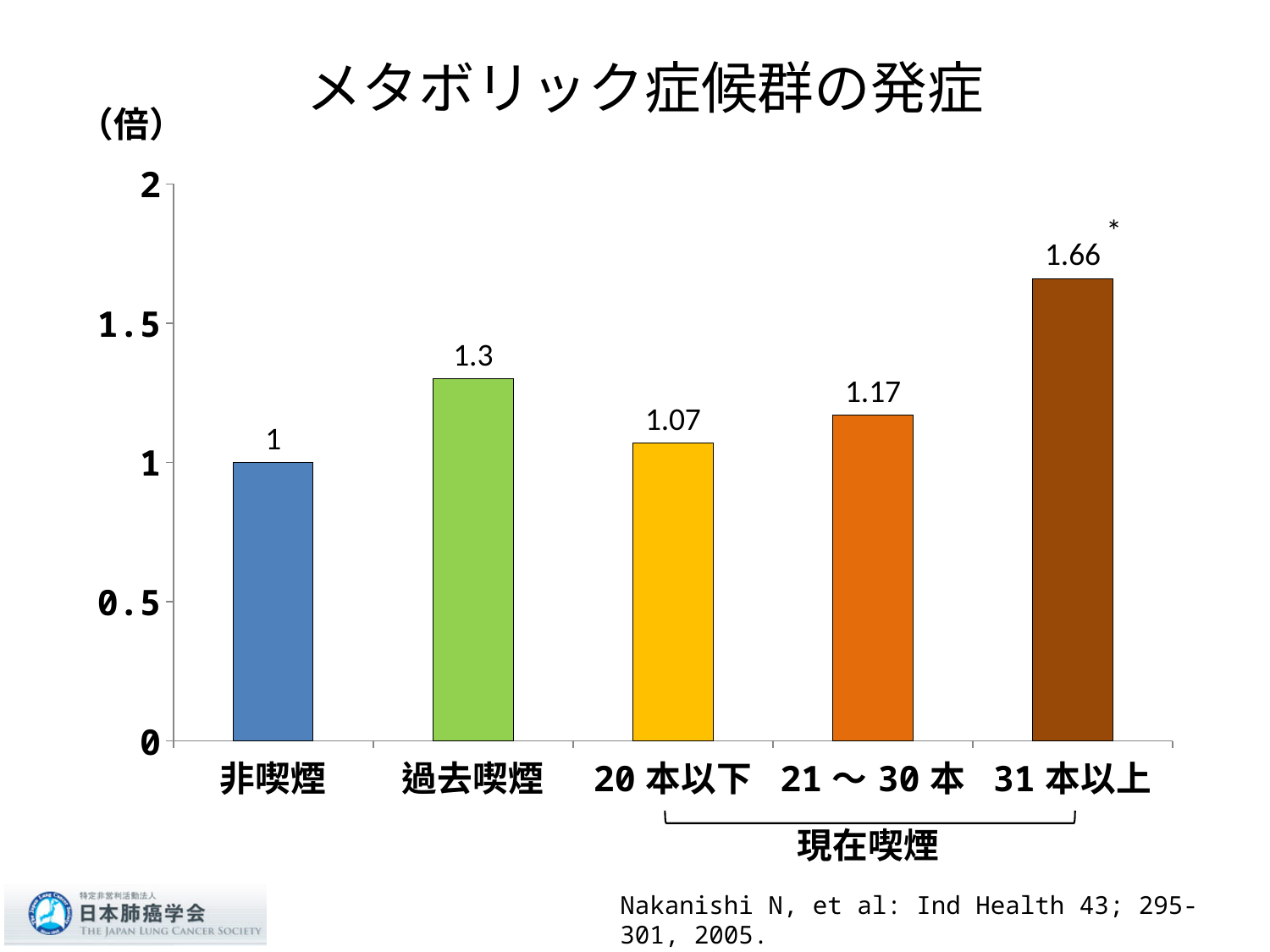
What is the difference between the values for 31本以上 and 非喫煙? 0.66 What is the value for 過去喫煙? 1.3 What is the value for 20本以下? 1.07 What is the title of the chart? メタボリック症候群の発症 Which category has the lowest value? 非喫煙 What is the value for 21～30本? 1.17 Which is larger, the value for 過去喫煙 or the value for 21～30本? 過去喫煙 What kind of chart is this? bar chart What is the value for 非喫煙? 1 Which category has the highest value? 31本以上 What is the value for 31本以上? 1.66 How many categories are shown on the x axis? 5